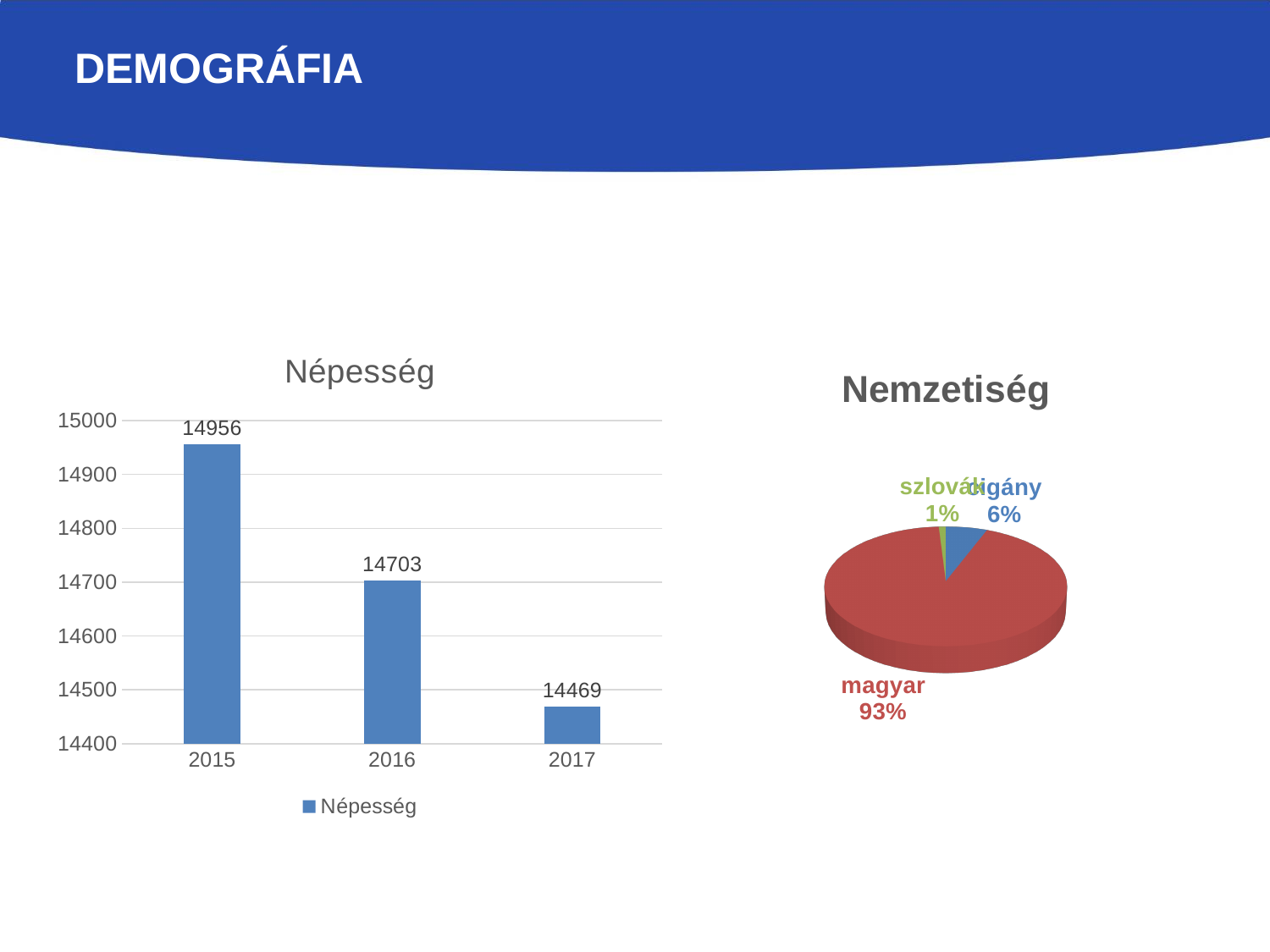
In the Nemzetiség chart, what share does cigány have? 6% In the Népesség chart, what is the difference between the values for 2015 and 2016? 253 How many years are shown in the Népesség chart? 3 In the Népesség chart, do the values rise or fall from 2015 to 2017? fall In the Népesség chart, which year has the highest value? 2015 In the Népesség chart, which year has the lowest value? 2017 In the Népesség chart, what is the value for 2015? 14956 In the Nemzetiség chart, what share does magyar have? 93% In the Népesség chart, what is the value for 2017? 14469 In the Népesség chart, which is larger, the value for 2016 or the value for 2017? 2016 What kind of chart is the Népesség chart? bar chart What kind of chart is the Nemzetiség chart? pie chart